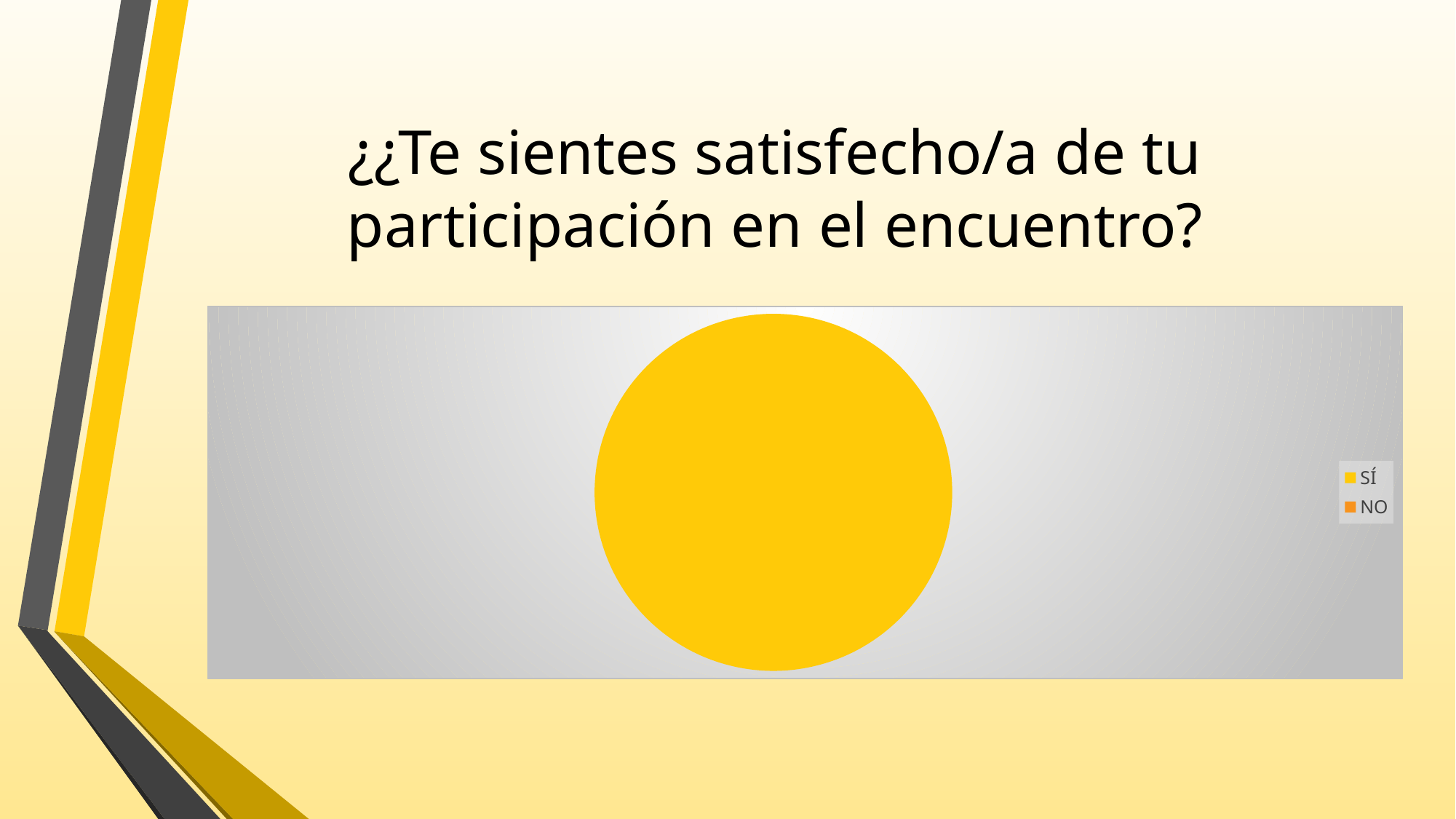
Which is larger in the pie chart, SÍ or NO? SÍ How many categories does the legend of the pie chart list? 2 Which category has the smallest slice in the pie chart? NO What colour represents SÍ in the pie chart legend? yellow Which category has the largest slice in the pie chart? SÍ What question is the pie chart on the slide about? ¿¿Te sientes satisfecho/a de tu participación en el encuentro? What kind of chart is shown on the slide? pie chart